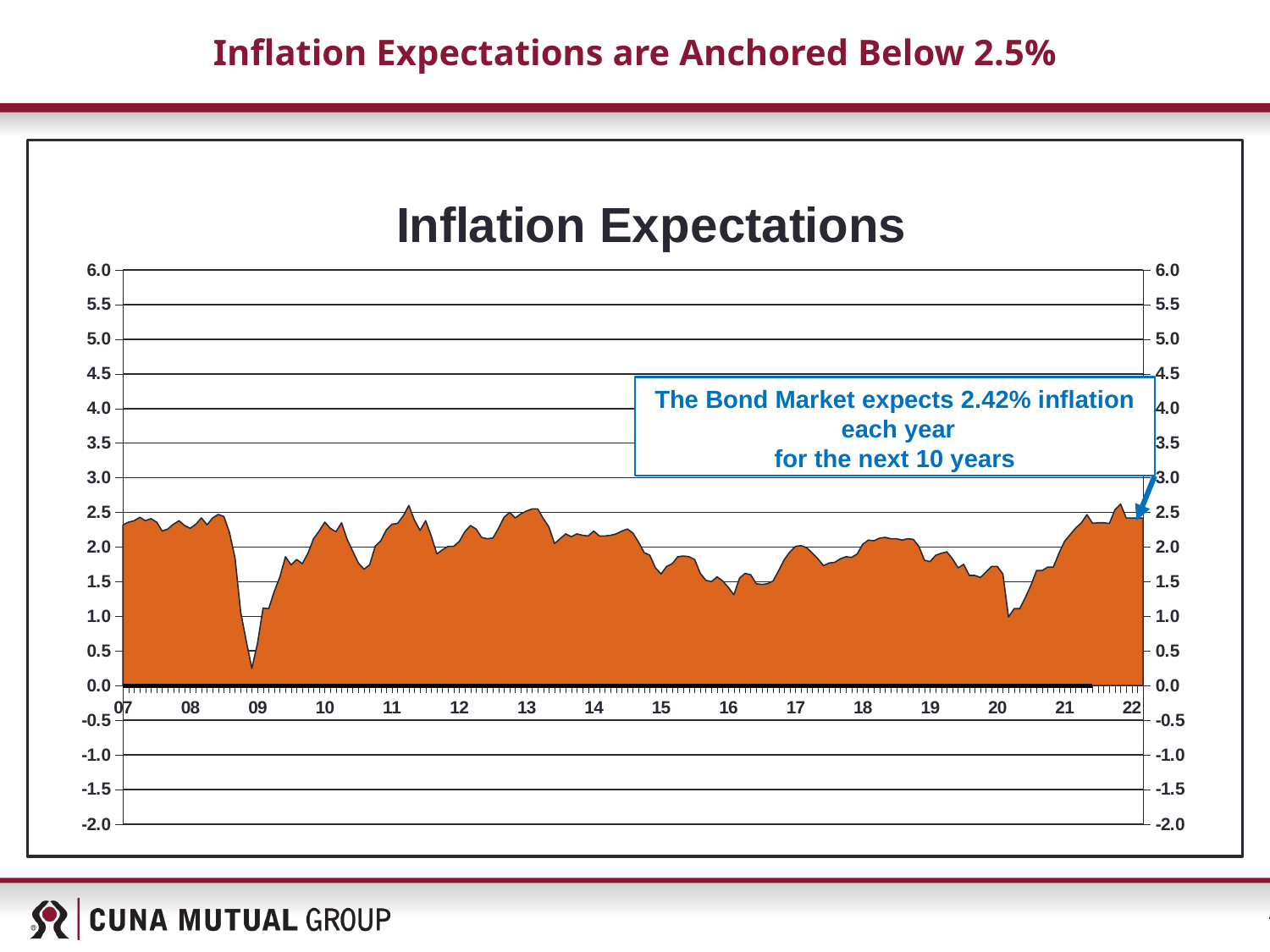
What is the title of the chart? Inflation Expectations Is the value at the start of 2007 greater or less than 2.0? greater According to the annotation on the chart, what annual inflation rate does the bond market expect for the next 10 years? 2.42% What is the highest value shown on the chart's y axis? 6.0 How many year labels are shown along the x axis of the chart? 16 Is the value in 2016 greater or less than 2.0? less What kind of chart is shown on the slide? area chart Do the values rise or fall between 2020 and 2022? rise Is the value in 2013 greater or less than 3.0? less Do the values rise or fall between 2008 and early 2009? fall